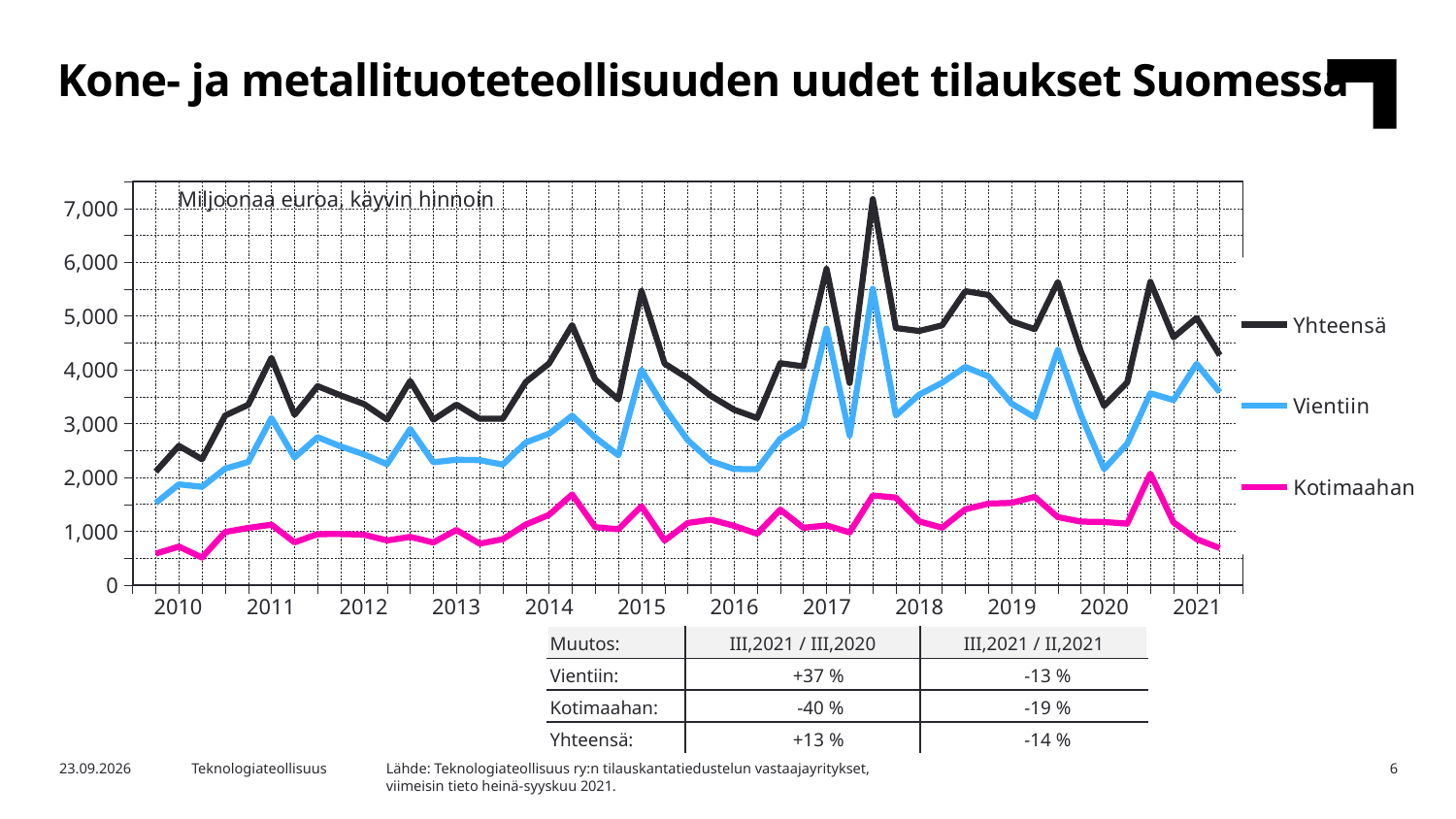
What kind of chart is shown on the slide? line chart Is the first value of the Yhteensä series in 2010 greater or less than 3,000? less Is the highest value of the Kotimaahan series greater or less than 3,000? less Which series has the highest values throughout the chart? Yhteensä Is the peak value of the Vientiin series in 2017 greater or less than 5,000? greater What are the three series named in the chart legend? Yhteensä, Vientiin, Kotimaahan How many series does the chart legend list? 3 What unit is stated in the chart's axis note? Miljoonaa euroa, käyvin hinnoin Which series is larger in 2021, Vientiin or Kotimaahan? Vientiin Which series has the lowest values throughout the chart? Kotimaahan Does the Yhteensä series rise or fall from the start of 2010 to the end of 2021 overall? rise